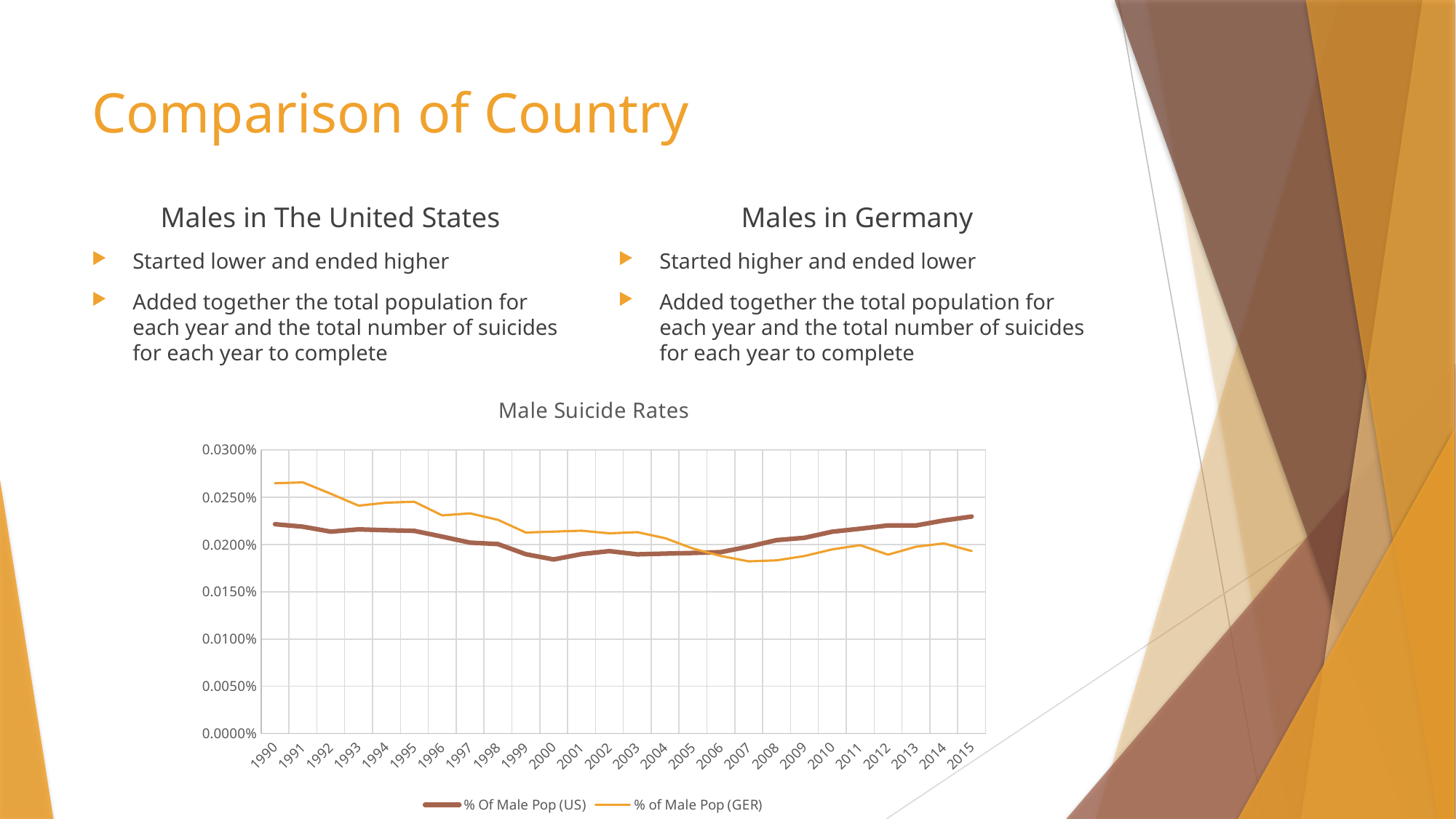
How many series does the chart's legend list? 2 Is the value for % of Male Pop (GER) in 1990 greater or less than 0.0250%? greater Which series is drawn in orange in the chart? % of Male Pop (GER) What is the title of the chart? Male Suicide Rates What kind of chart is shown on the slide? Line chart Is the value for % Of Male Pop (US) in 2000 greater or less than 0.0200%? less Does the % of Male Pop (GER) series generally rise or fall from 1990 to 2015? Fall Is the value for % Of Male Pop (US) in 2015 greater or less than 0.0200%? greater In 1990, which series has the higher value: % Of Male Pop (US) or % of Male Pop (GER)? % of Male Pop (GER) How many years are plotted along the x axis of the chart? 26 In 2015, which series has the higher value: % Of Male Pop (US) or % of Male Pop (GER)? % Of Male Pop (US)